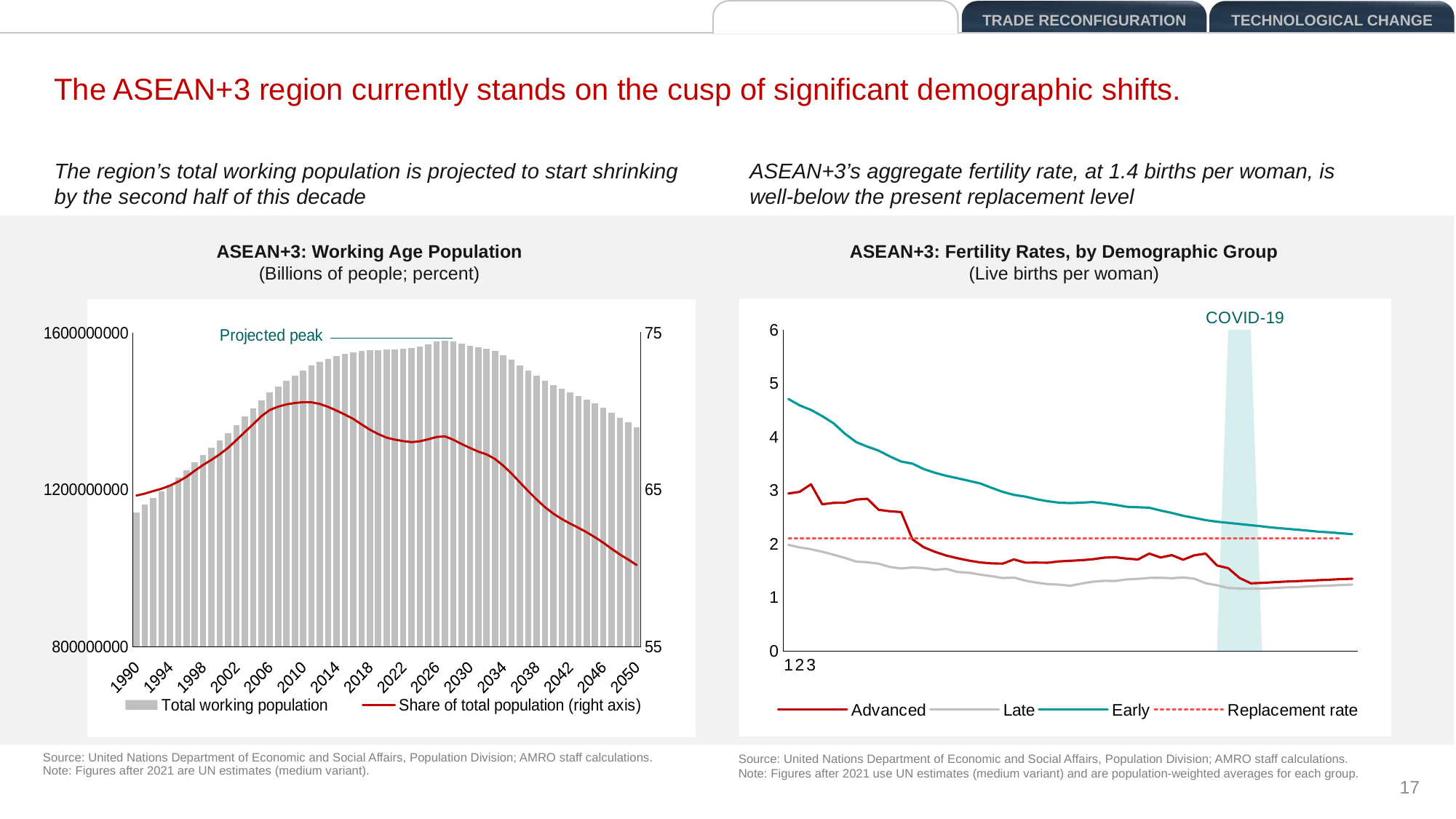
In the 'ASEAN+3: Working Age Population' chart, is the share of total population (right axis) in 2010 greater or less than 65? greater In the 'ASEAN+3: Fertility Rates, by Demographic Group' chart, is the Early group's fertility rate at the start of the series greater or less than 4? greater What kind of chart is the 'ASEAN+3: Working Age Population' chart on the left? A bar chart with a line overlay How many series does the legend of the 'ASEAN+3: Fertility Rates, by Demographic Group' chart list? 4 What event is labelled by the shaded vertical band in the 'ASEAN+3: Fertility Rates, by Demographic Group' chart? COVID-19 In the 'ASEAN+3: Working Age Population' chart, is the share of total population (right axis) in 2050 greater or less than 65? less In the 'ASEAN+3: Fertility Rates, by Demographic Group' chart, which group has the higher fertility rate at the start of the series, Early or Late? Early What kind of chart is the 'ASEAN+3: Fertility Rates, by Demographic Group' chart on the right? Line chart How many series does the legend of the 'ASEAN+3: Working Age Population' chart list? 2 In the 'ASEAN+3: Fertility Rates, by Demographic Group' chart, does the Early group's fertility rate rise or fall along the x axis? Fall